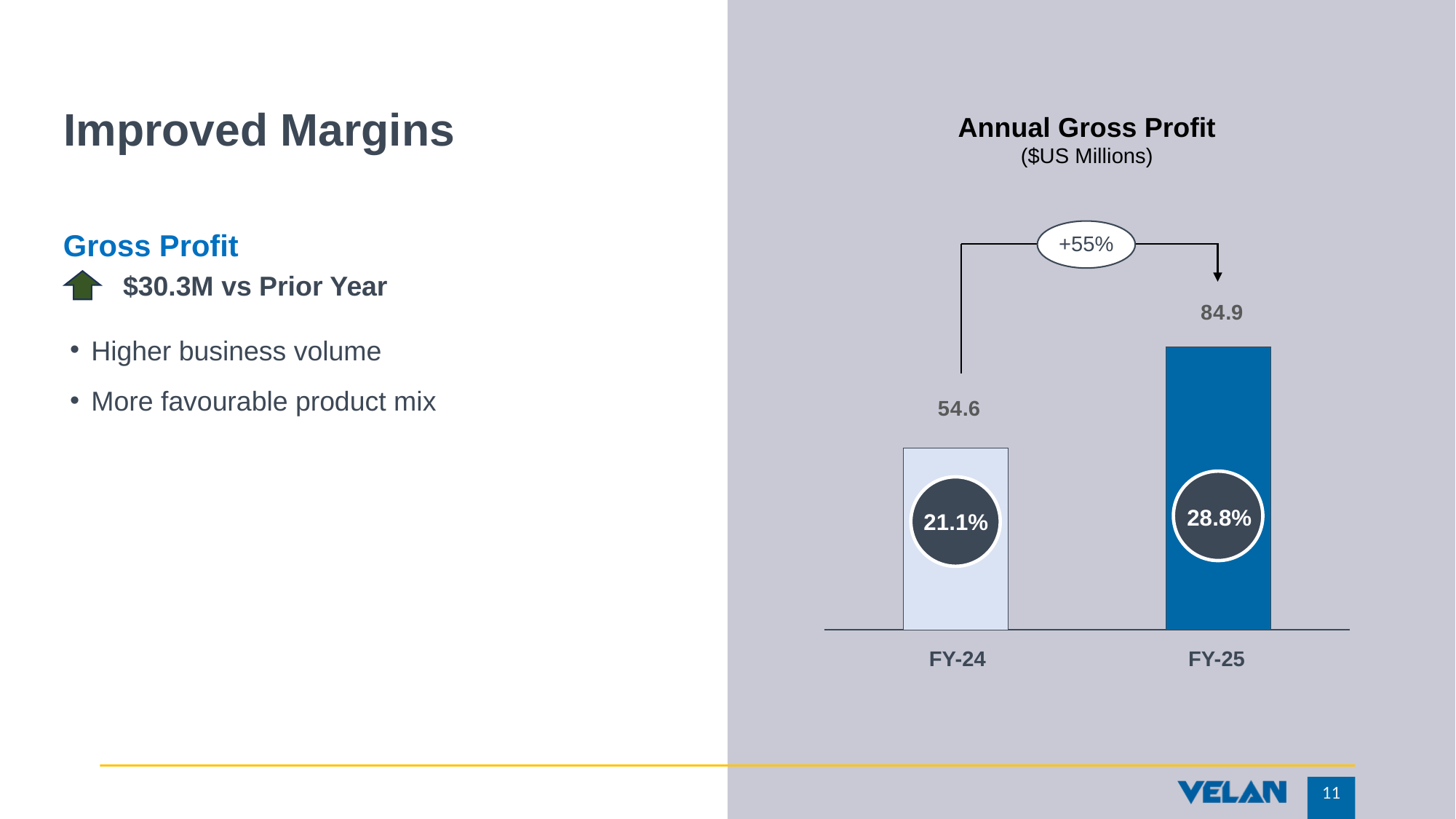
What is the annual gross profit for FY-24? 54.6 What is the difference in annual gross profit between FY-25 and FY-24? 30.3 What gross margin percentage is shown on the FY-25 bar? 28.8% Which fiscal year has the higher annual gross profit? FY-25 How many fiscal years are shown in the chart? 2 What kind of chart is used to show annual gross profit? bar chart What percentage change is shown between FY-24 and FY-25 in the chart? +55% Which fiscal year has the lower annual gross profit? FY-24 What is the annual gross profit for FY-25? 84.9 What gross margin percentage is shown on the FY-24 bar? 21.1% Is the annual gross profit for FY-25 larger or smaller than for FY-24? larger What unit is the annual gross profit chart measured in? $US Millions